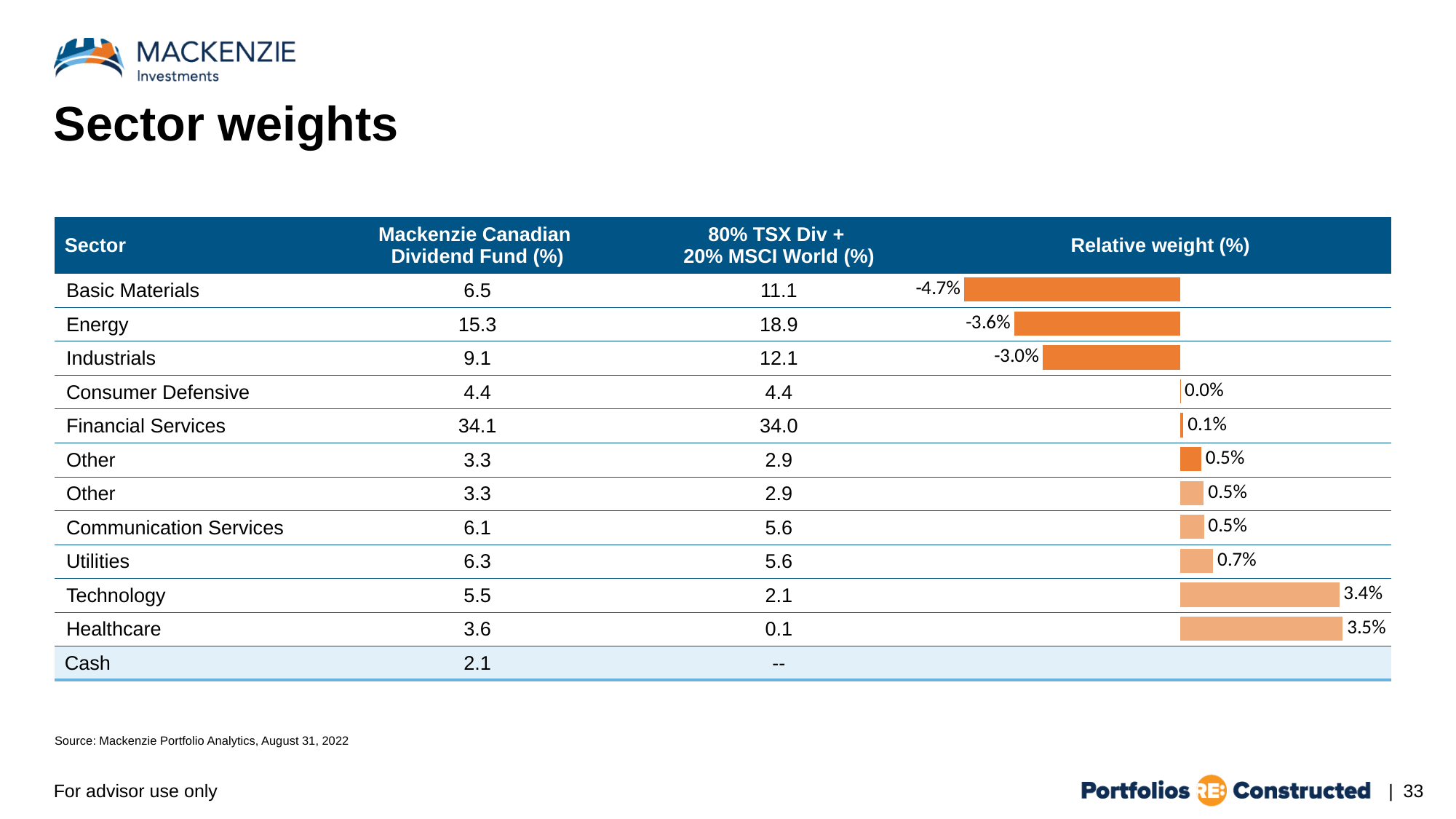
How many sectors have a negative relative weight in the Relative weight (%) chart? 3 In the Relative weight (%) chart, which has the more negative relative weight, Energy or Industrials? Energy In the Relative weight (%) chart, what is the difference between the relative weights of Technology and Industrials? 6.4 percentage points What is the relative weight shown for Energy in the Relative weight (%) chart? -3.6% What is the relative weight shown for Utilities in the Relative weight (%) chart? 0.7% In the Relative weight (%) chart, which has the larger relative weight, Utilities or Communication Services? Utilities What is the relative weight shown for Basic Materials in the Relative weight (%) chart? -4.7% What is the relative weight shown for Technology in the Relative weight (%) chart? 3.4% Which sector has the highest relative weight in the Relative weight (%) chart? Healthcare What kind of chart is used in the Relative weight (%) column? Bar chart In the Relative weight (%) chart, what is the difference between the relative weights of Basic Materials and Energy? 1.1 percentage points Which sector has the lowest (most negative) relative weight in the Relative weight (%) chart? Basic Materials